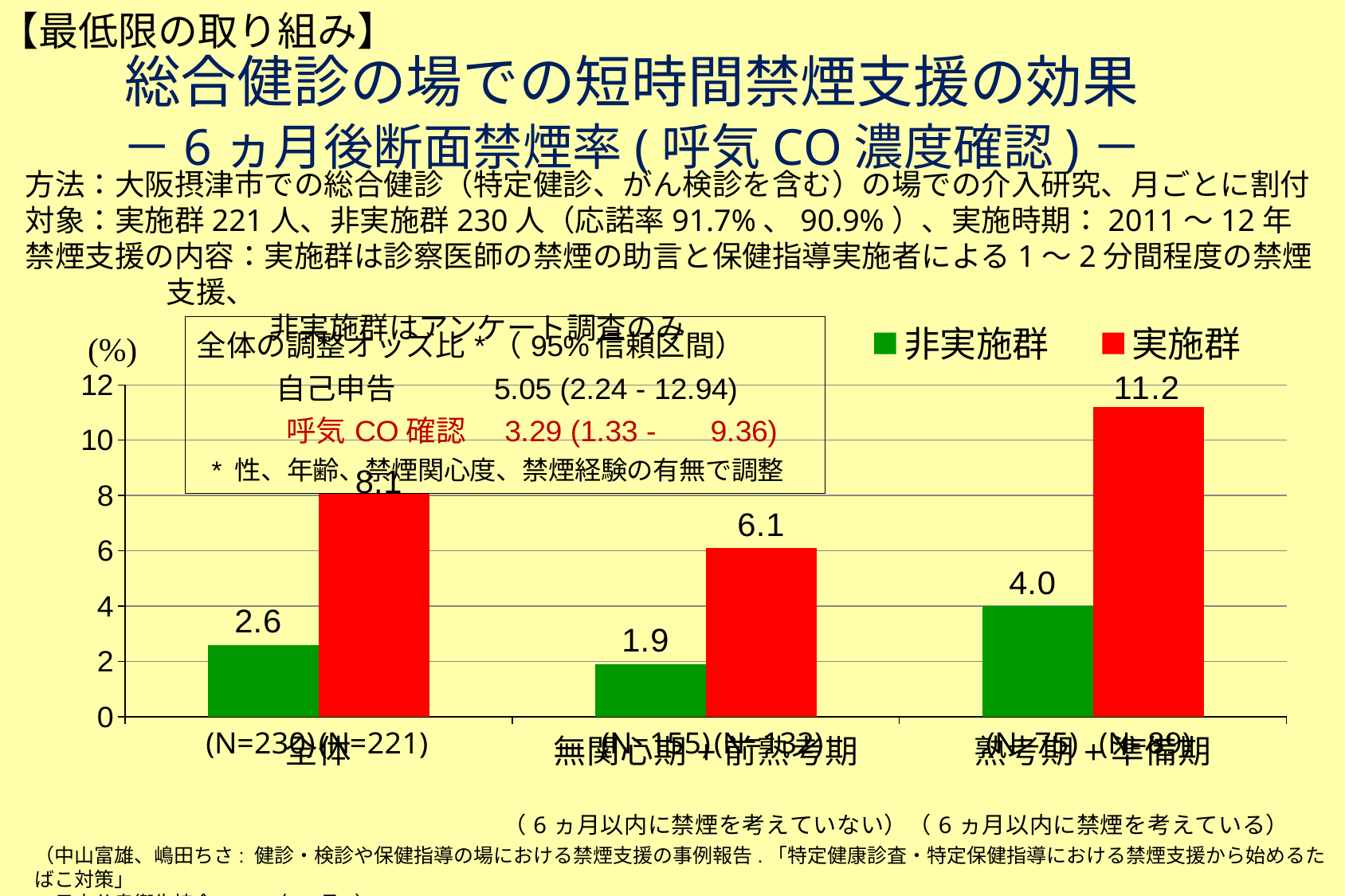
How many series does the legend list? 2 How many categories are shown on the x axis? 3 What is the value for 非実施群 in the 全体 category? 2.6 What kind of chart is shown on the slide? bar chart Which category has the highest value for 実施群? 熟考期＋準備期 What is the value for 非実施群 in the 無関心期＋前熟考期 category? 1.9 In the 無関心期＋前熟考期 category, which series has the larger value, 実施群 or 非実施群? 実施群 Which category has the lowest value for 非実施群? 無関心期＋前熟考期 What is the difference between 実施群 and 非実施群 in the 熟考期＋準備期 category? 7.2 What is the value for 実施群 in the 全体 category? 8.1 What is the value for 実施群 in the 熟考期＋準備期 category? 11.2 Which colour represents 非実施群 in the legend? green